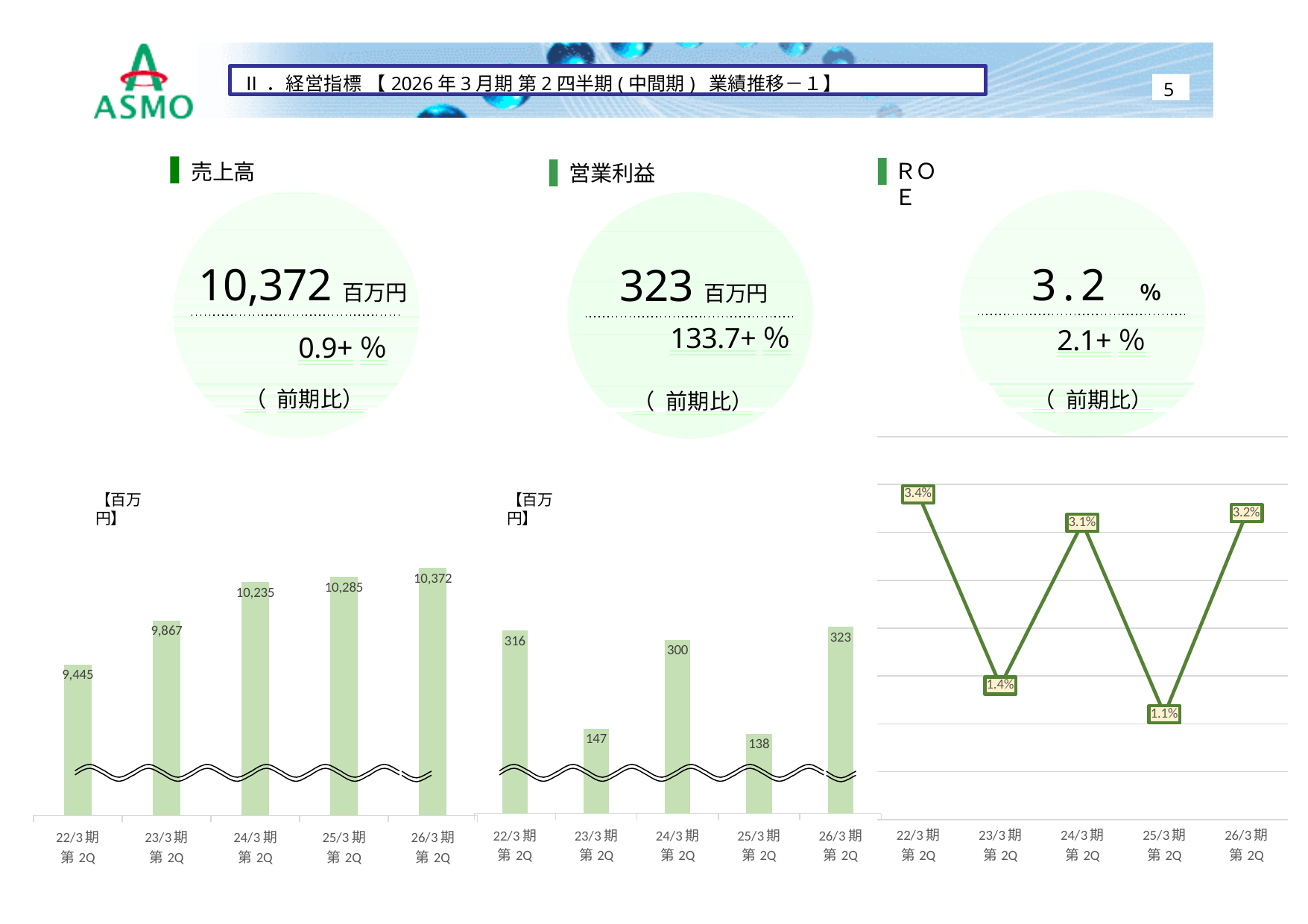
In the 売上高 (sales) chart, which period has the lowest value? 22/3期 第2Q What kind of chart is the ROE chart? line chart In the 営業利益 (operating profit) chart, what is the value for 25/3期 第2Q? 138 In the 営業利益 (operating profit) chart, what is the difference between 26/3期 第2Q and 25/3期 第2Q? 185 In the 売上高 (sales) chart, what is the value for 26/3期 第2Q? 10,372 How many periods are plotted in the 売上高 (sales) chart? 5 In the 営業利益 (operating profit) chart, which is larger, 22/3期 第2Q or 24/3期 第2Q? 22/3期 第2Q In the 売上高 (sales) chart, do the values rise or fall from 22/3期 第2Q to 26/3期 第2Q? rise In the 営業利益 (operating profit) chart, which period has the highest value? 26/3期 第2Q In the 売上高 (sales) chart, what is the difference between 26/3期 第2Q and 22/3期 第2Q? 927 In the ROE chart, which period has the lowest value? 25/3期 第2Q In the ROE chart, what is the value for 23/3期 第2Q? 1.4%